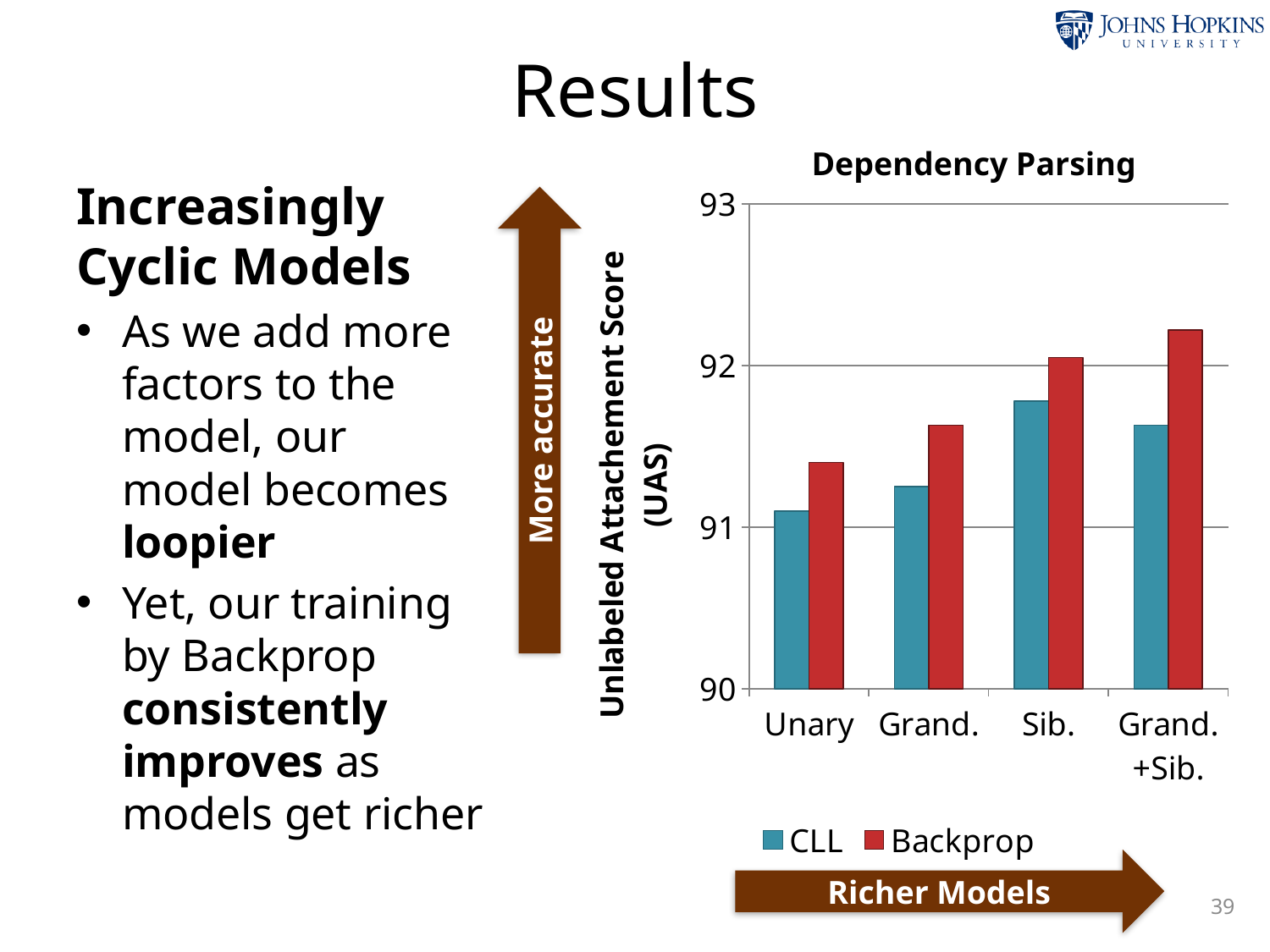
In the Dependency Parsing chart, which is larger for the Sib. category: CLL or Backprop? Backprop How many model categories are shown on the x axis of the Dependency Parsing chart? 4 What is the y-axis label of the Dependency Parsing chart? Unlabeled Attachement Score (UAS) In the Dependency Parsing chart, is the Backprop value for Grand.+Sib. greater or less than 92? greater How many series does the legend of the Dependency Parsing chart list? 2 In the Dependency Parsing chart, is the Backprop value for Unary greater or less than 92? less In the Dependency Parsing chart, do the Backprop values rise or fall from Unary to Grand.+Sib.? rise In the Dependency Parsing chart, is the CLL value for Sib. greater or less than 92? less In the Dependency Parsing chart, which category has the lowest CLL value? Unary In the Dependency Parsing chart, which category has the highest Backprop value? Grand.+Sib. Which series in the Dependency Parsing chart is drawn in red? Backprop What kind of chart is shown under the title "Dependency Parsing"? bar chart